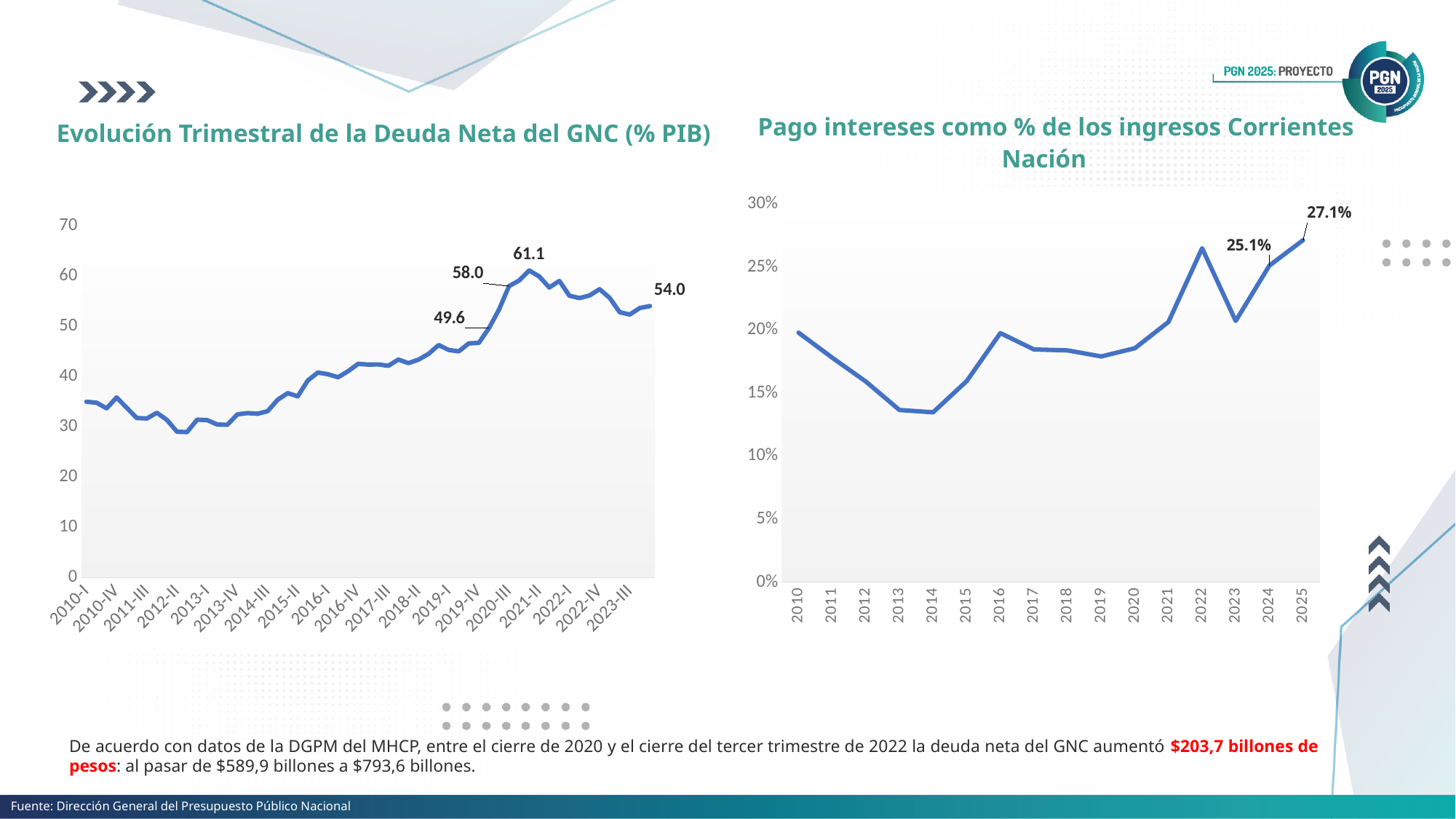
In the chart 'Pago intereses como % de los ingresos Corrientes Nación', which is larger, the value for 2022 or the value for 2023? 2022 In the chart 'Pago intereses como % de los ingresos Corrientes Nación', is the value for 2014 greater or less than 15%? less In the chart 'Pago intereses como % de los ingresos Corrientes Nación', which year has the highest value? 2025 In the chart 'Pago intereses como % de los ingresos Corrientes Nación', is the value for 2022 greater or less than 25%? greater What type of chart is 'Evolución Trimestral de la Deuda Neta del GNC (% PIB)'? line chart In the chart 'Pago intereses como % de los ingresos Corrientes Nación', what is the value for 2025? 27.1% In the chart 'Evolución Trimestral de la Deuda Neta del GNC (% PIB)', is the value for 2010-I greater or less than 30? greater In the chart 'Evolución Trimestral de la Deuda Neta del GNC (% PIB)', what is the highest labelled value on the line? 61.1 In the chart 'Pago intereses como % de los ingresos Corrientes Nación', what is the value for 2024? 25.1% In the chart 'Evolución Trimestral de la Deuda Neta del GNC (% PIB)', what is the value labelled at the last point of the line? 54.0 In the chart 'Evolución Trimestral de la Deuda Neta del GNC (% PIB)', what is the difference between the peak value 61.1 and the final value 54.0? 7.1 In the chart 'Pago intereses como % de los ingresos Corrientes Nación', how many years are shown on the x axis? 16